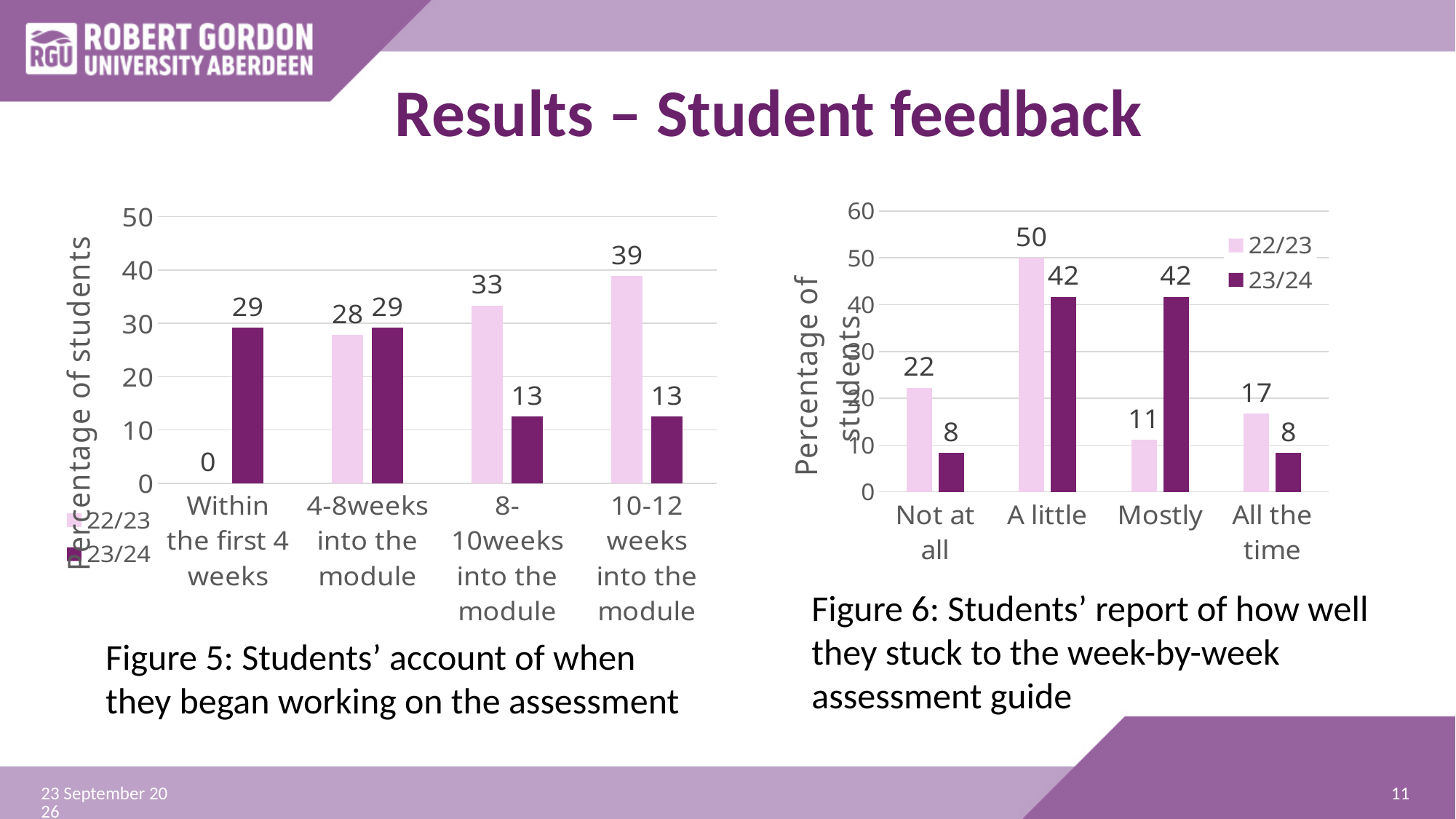
In Figure 5 (left chart), what is the difference between the 22/23 and 23/24 values for '8-10weeks into the module'? 20 In Figure 5 (left chart), what is the 23/24 value for 'Within the first 4 weeks'? 29 In Figure 6 (right chart), which category has the lowest 22/23 value? Mostly In Figure 5 (left chart), what is the 22/23 value for '10-12 weeks into the module'? 39 In Figure 6 (right chart), which is larger for 'Not at all': the 22/23 value or the 23/24 value? 22/23 In Figure 6 (right chart), what is the 23/24 value for 'Mostly'? 42 What type of chart is Figure 6 (right chart)? Bar chart In Figure 6 (right chart), how many series does the legend list? 2 In Figure 5 (left chart), how many categories are shown on the x axis? 4 In Figure 5 (left chart), how do the 22/23 values change from left to right across the categories? They rise In Figure 5 (left chart), which category has the highest 22/23 value? 10-12 weeks into the module In Figure 6 (right chart), what is the 22/23 value for 'A little'? 50